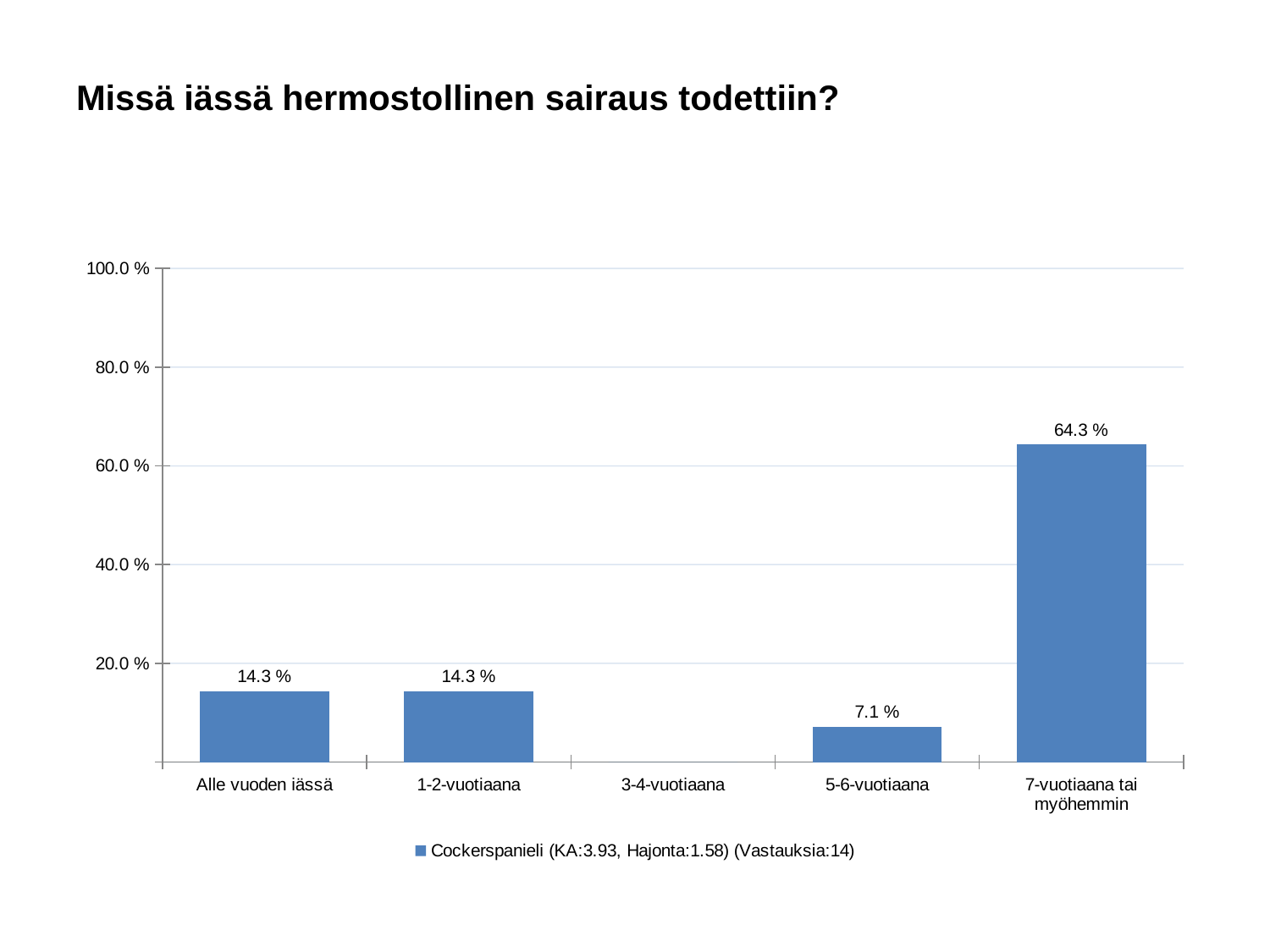
How many categories are shown on the x axis? 5 What is the difference between the values for "7-vuotiaana tai myöhemmin" and "5-6-vuotiaana"? 57.2 % How many series does the legend list? 1 What kind of chart is shown on the slide? bar chart Is the value for "7-vuotiaana tai myöhemmin" greater or less than 60.0 %? greater What is the value for "7-vuotiaana tai myöhemmin"? 64.3 % What is the value for "1-2-vuotiaana"? 14.3 % Which is larger, the value for "1-2-vuotiaana" or the value for "5-6-vuotiaana"? 1-2-vuotiaana What is the difference between the values for "Alle vuoden iässä" and "5-6-vuotiaana"? 7.2 % Which category has the highest value? 7-vuotiaana tai myöhemmin What is the value for "5-6-vuotiaana"? 7.1 % What is the value for "Alle vuoden iässä"? 14.3 %